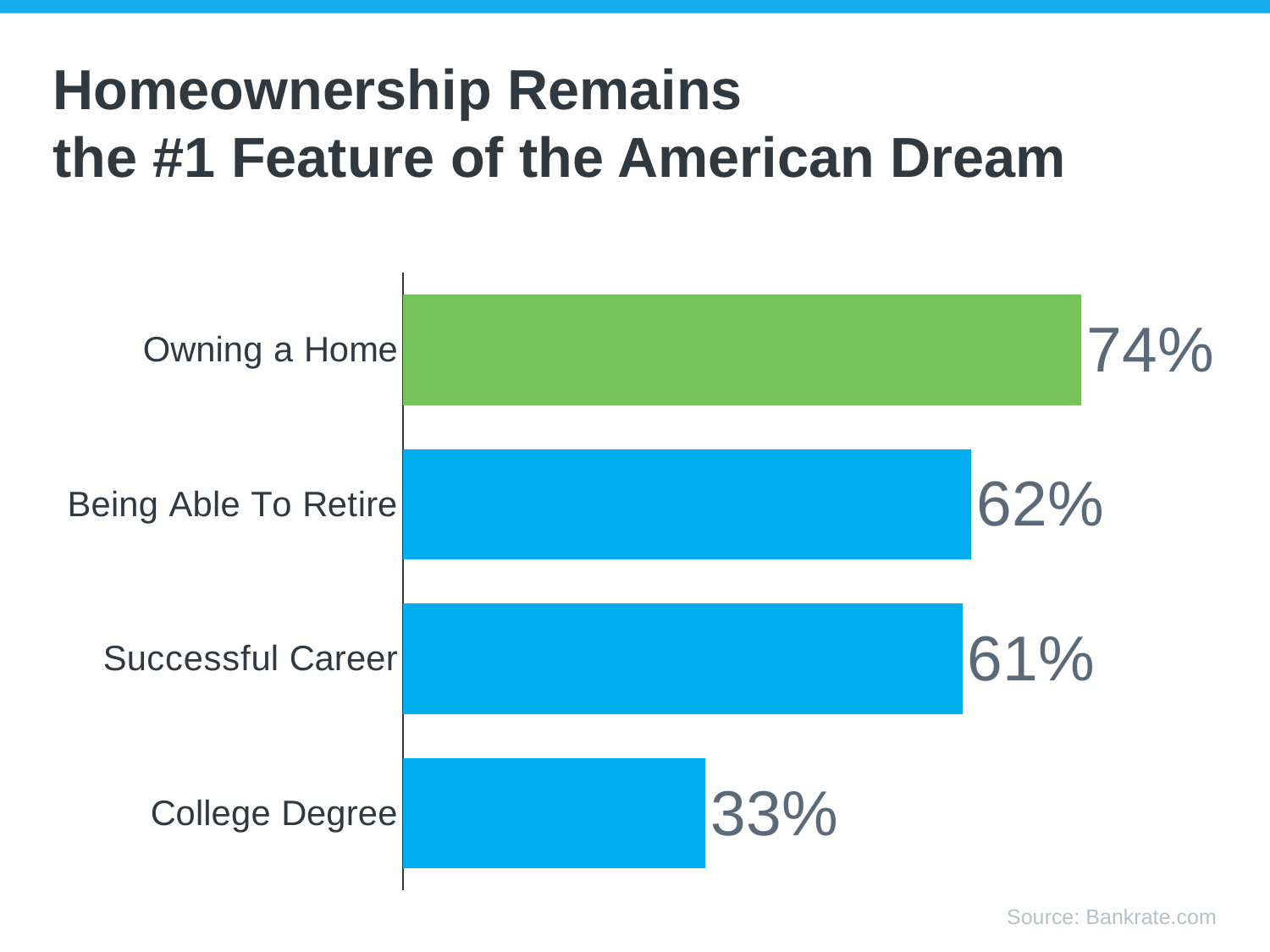
What kind of chart is shown on the slide? Bar chart Which bar is coloured green rather than blue? Owning a Home How many categories are shown in the chart? 4 What is the value for College Degree? 33% Which category has the lowest value? College Degree What is the value for Successful Career? 61% What is the value for Being Able To Retire? 62% Which category has the highest value? Owning a Home What is the difference between the values for Owning a Home and College Degree? 41% What is the value for Owning a Home? 74% What is the difference between the values for Owning a Home and Being Able To Retire? 12% Which is larger, the value for Being Able To Retire or the value for College Degree? Being Able To Retire